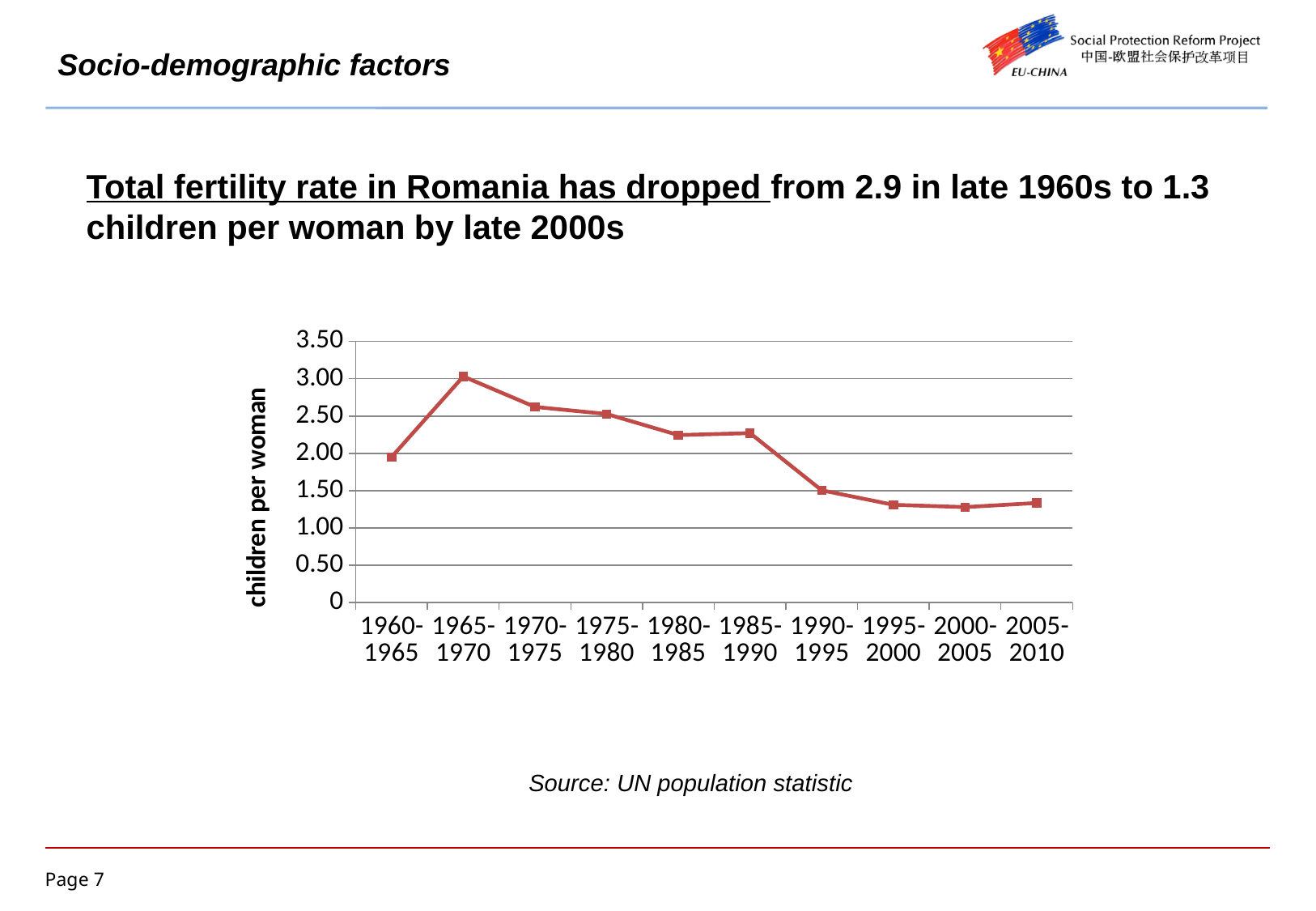
Is the value for 2005-2010 greater or less than 1.50? less Is the value for 1980-1985 greater or less than 2.00? greater Which is larger, the value for 1960-1965 or the value for 1990-1995? 1960-1965 What is the label on the vertical axis of the chart? children per woman Is the value for 2000-2005 greater or less than 1.00? greater Which period has the highest total fertility rate in the chart? 1965-1970 Overall, do the values in the chart rise or fall from 1965-1970 to 2005-2010? fall What kind of chart is shown on the slide? line chart What source is cited below the chart? UN population statistic How many time periods are plotted on the x axis of the chart? 10